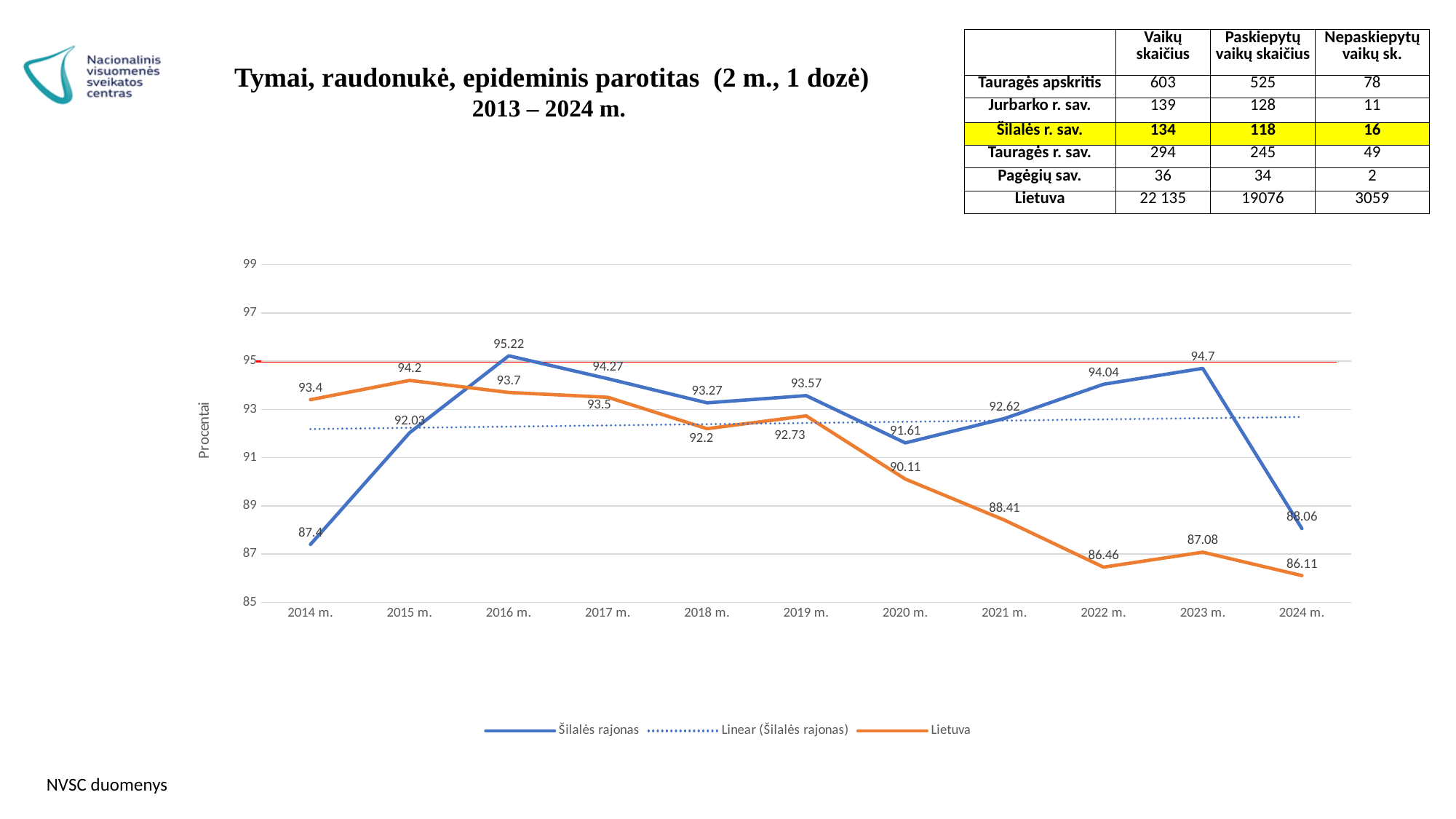
In which year does the Lietuva series have its lowest value? 2024 m. What is the value for Šilalės rajonas in 2016 m.? 95.22 Does the Lietuva series rise or fall from 2019 m. to 2022 m.? fall What is the value for Lietuva in 2024 m.? 86.11 Is the value for Lietuva in 2022 m. greater or less than 87? less How many entries does the legend list? 3 In 2014 m., which series has the larger value, Šilalės rajonas or Lietuva? Lietuva In which year does the Šilalės rajonas series have its lowest value? 2014 m. What is the difference between Šilalės rajonas and Lietuva in 2024 m.? 1.95 What kind of chart is shown on the slide? line chart How many years are shown on the x axis? 11 In which year does the Šilalės rajonas series reach its highest value? 2016 m.